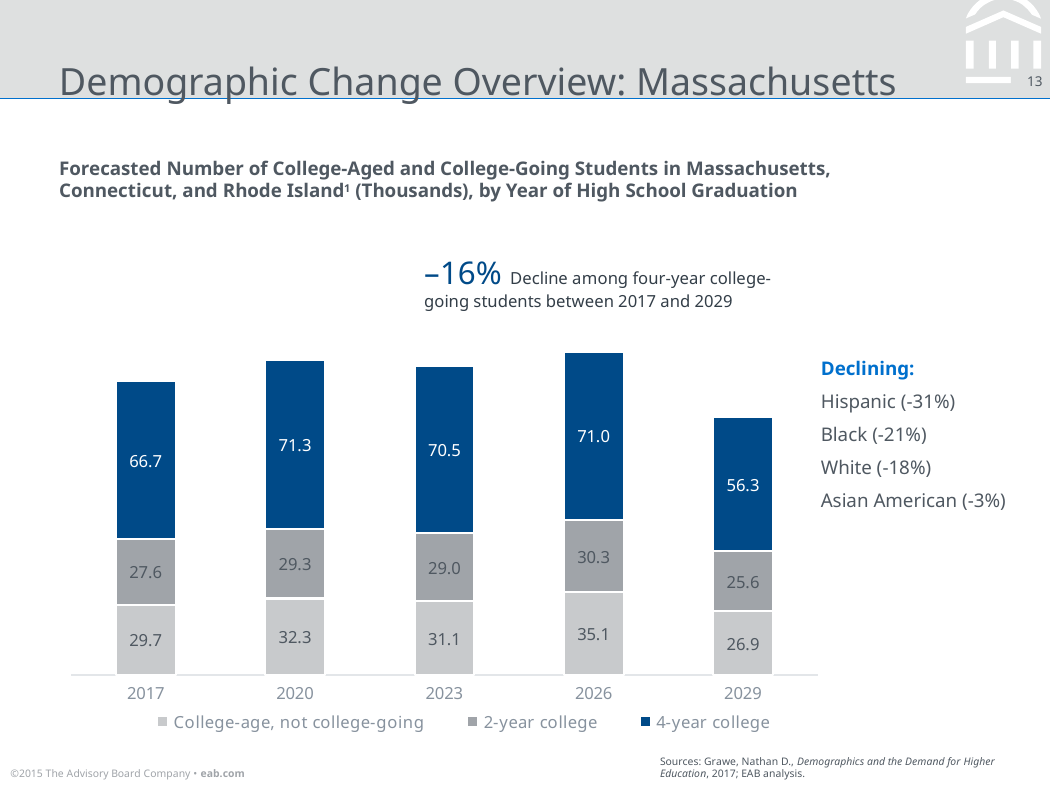
How many years are shown on the x axis? 5 Which is larger, the College-age, not college-going value for 2026 or for 2020? 2026 What is the difference between the 4-year college values for 2017 and 2029? 10.4 What is the value for 4-year college in 2017? 66.7 What is the total of the stacked bar for 2017? 124.0 Which year has the highest value for 4-year college? 2020 What is the value for College-age, not college-going in 2029? 26.9 How many series does the legend list? 3 What is the total of the stacked bar for 2029? 108.8 What kind of chart is shown on the slide? Stacked bar chart What is the value for 2-year college in 2026? 30.3 Which year has the lowest value for 2-year college? 2029